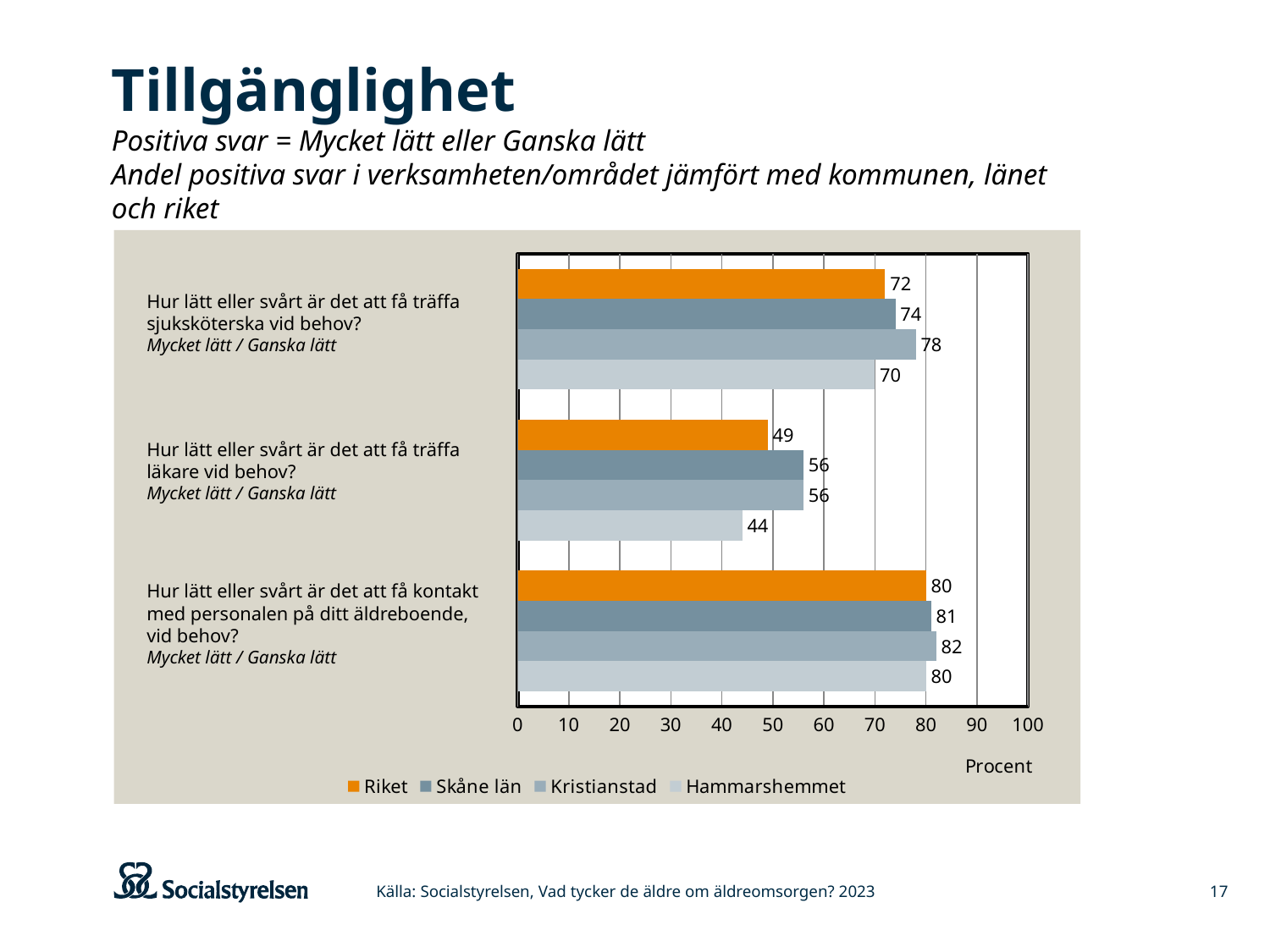
What is the difference between Skåne län and Hammarshemmet for 'Hur lätt eller svårt är det att få träffa läkare vid behov?' 12 How many series does the legend list? 4 For 'Hur lätt eller svårt är det att få träffa sjuksköterska vid behov?', which is larger: Riket or Skåne län? Skåne län Which series has the lowest value for 'Hur lätt eller svårt är det att få träffa läkare vid behov?' Hammarshemmet What is the value for Kristianstad for 'Hur lätt eller svårt är det att få kontakt med personalen på ditt äldreboende, vid behov?' 82 What is the difference between Kristianstad and Riket for 'Hur lätt eller svårt är det att få träffa sjuksköterska vid behov?' 6 What is the value for Riket for 'Hur lätt eller svårt är det att få träffa läkare vid behov?' 49 What kind of chart is shown on the slide? Bar chart Which series has the highest value for 'Hur lätt eller svårt är det att få träffa sjuksköterska vid behov?' Kristianstad What is the value for Hammarshemmet for 'Hur lätt eller svårt är det att få träffa sjuksköterska vid behov?' 70 What label is shown on the horizontal axis of the chart? Procent How many question categories are plotted on the chart? 3